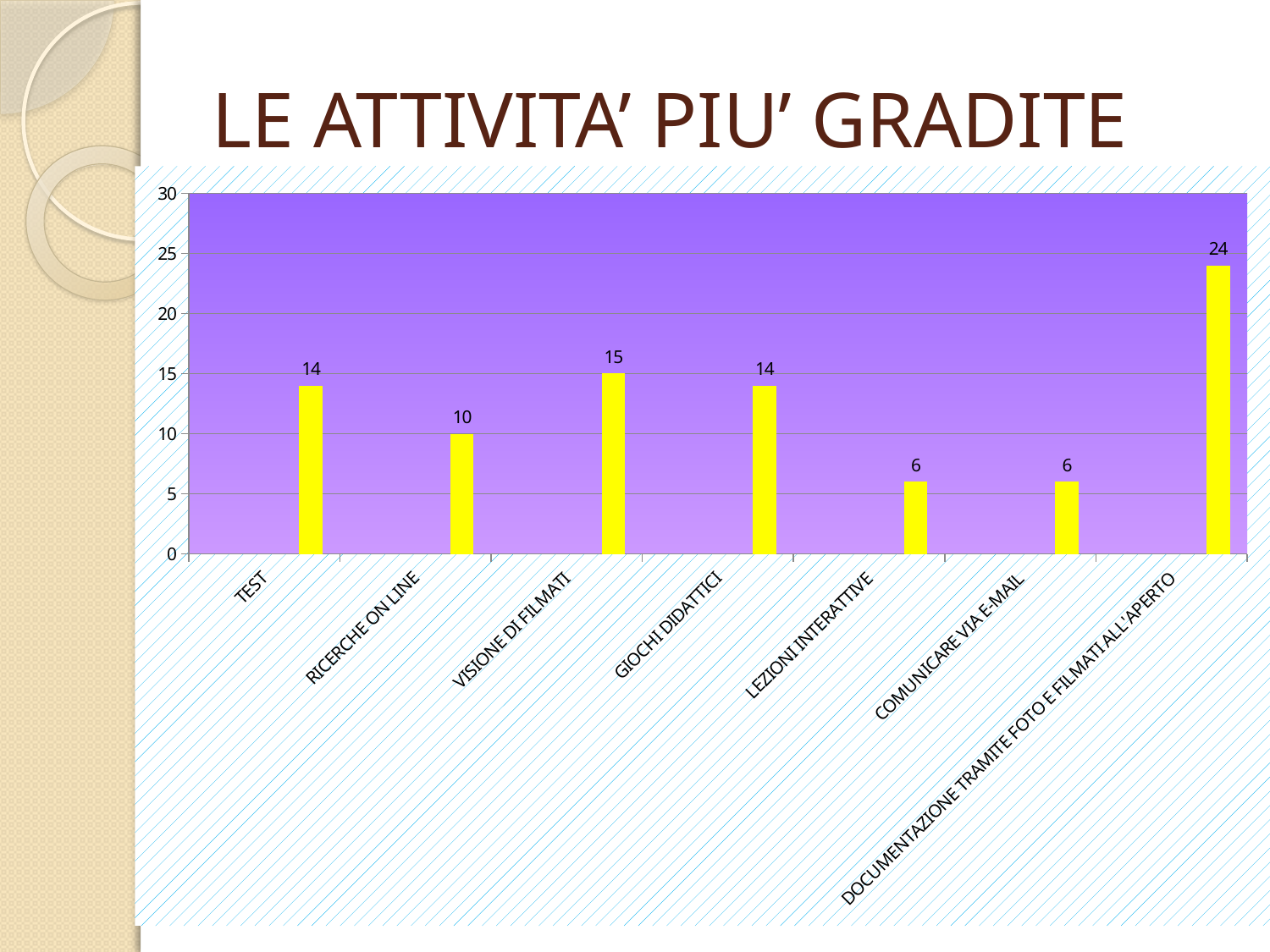
What is the value for VISIONE DI FILMATI? 15 What colour are the bars in the chart? yellow What is the value for RICERCHE ON LINE? 10 How many categories are shown on the x axis? 7 What kind of chart is shown on the slide? bar chart What is the difference between the values for DOCUMENTAZIONE TRAMITE FOTO E FILMATI ALL'APERTO and VISIONE DI FILMATI? 9 What is the value for DOCUMENTAZIONE TRAMITE FOTO E FILMATI ALL'APERTO? 24 Which category has the highest value? DOCUMENTAZIONE TRAMITE FOTO E FILMATI ALL'APERTO Which is larger, the value for GIOCHI DIDATTICI or the value for LEZIONI INTERATTIVE? GIOCHI DIDATTICI What is the value for TEST? 14 What is the title of the slide? LE ATTIVITA' PIU' GRADITE Is the value for COMUNICARE VIA E-MAIL greater or less than 10? less